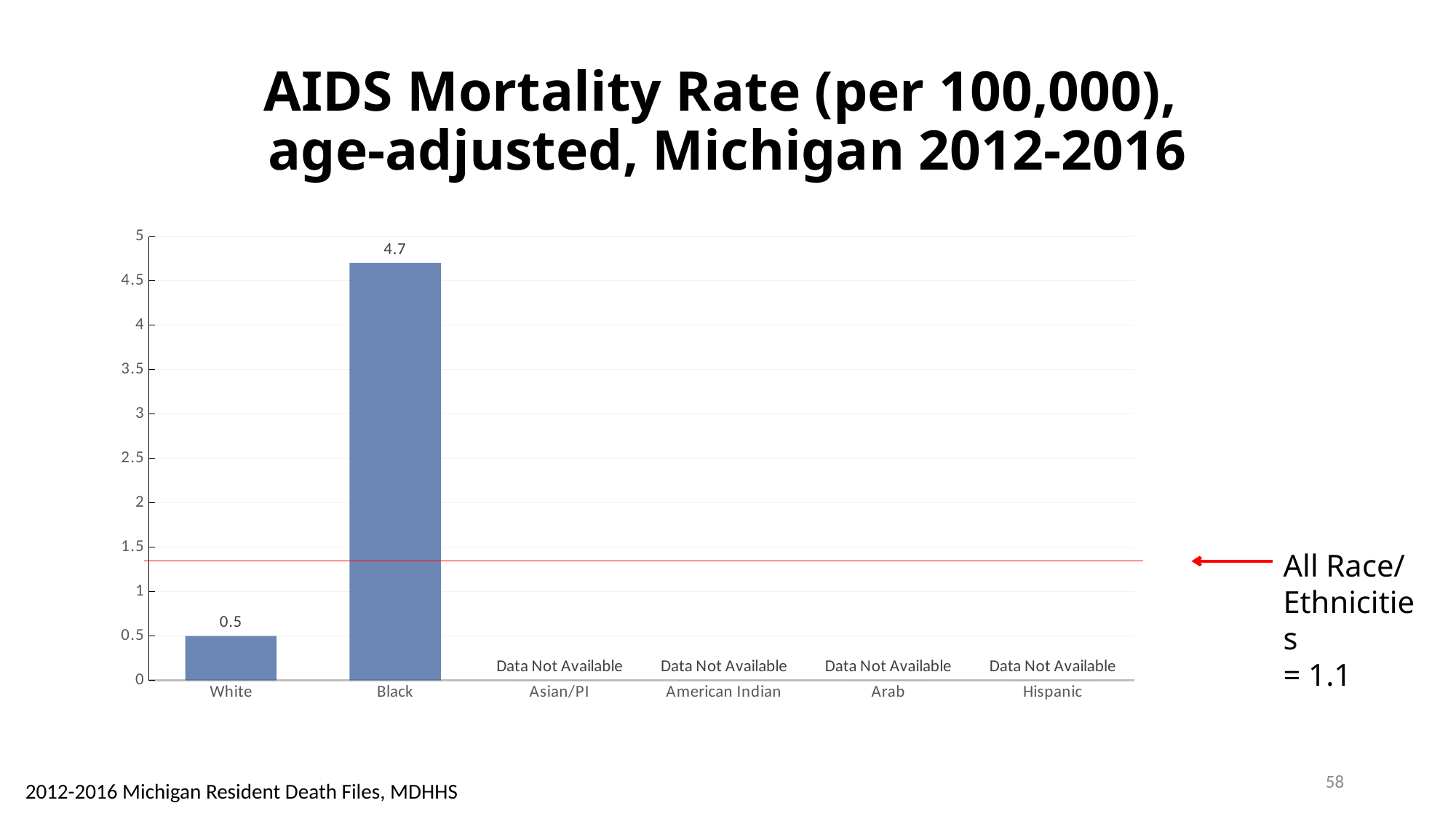
Is the value for White greater or less than 1? less How many categories are marked as 'Data Not Available'? 4 What kind of chart is shown on the slide? Bar chart Which race/ethnicity category has the highest AIDS mortality rate shown? Black Which is larger, the AIDS mortality rate for Black residents or for White residents? Black What is the AIDS mortality rate for all race/ethnicities combined, as indicated by the red line? 1.1 How many race/ethnicity categories are listed on the x axis? 6 What is the difference between the AIDS mortality rates for Black and White residents? 4.2 What is the data source cited at the bottom of the slide? 2012-2016 Michigan Resident Death Files, MDHHS Is the value for Black greater or less than 4? greater What is the AIDS mortality rate for White residents? 0.5 What is the AIDS mortality rate for Black residents? 4.7